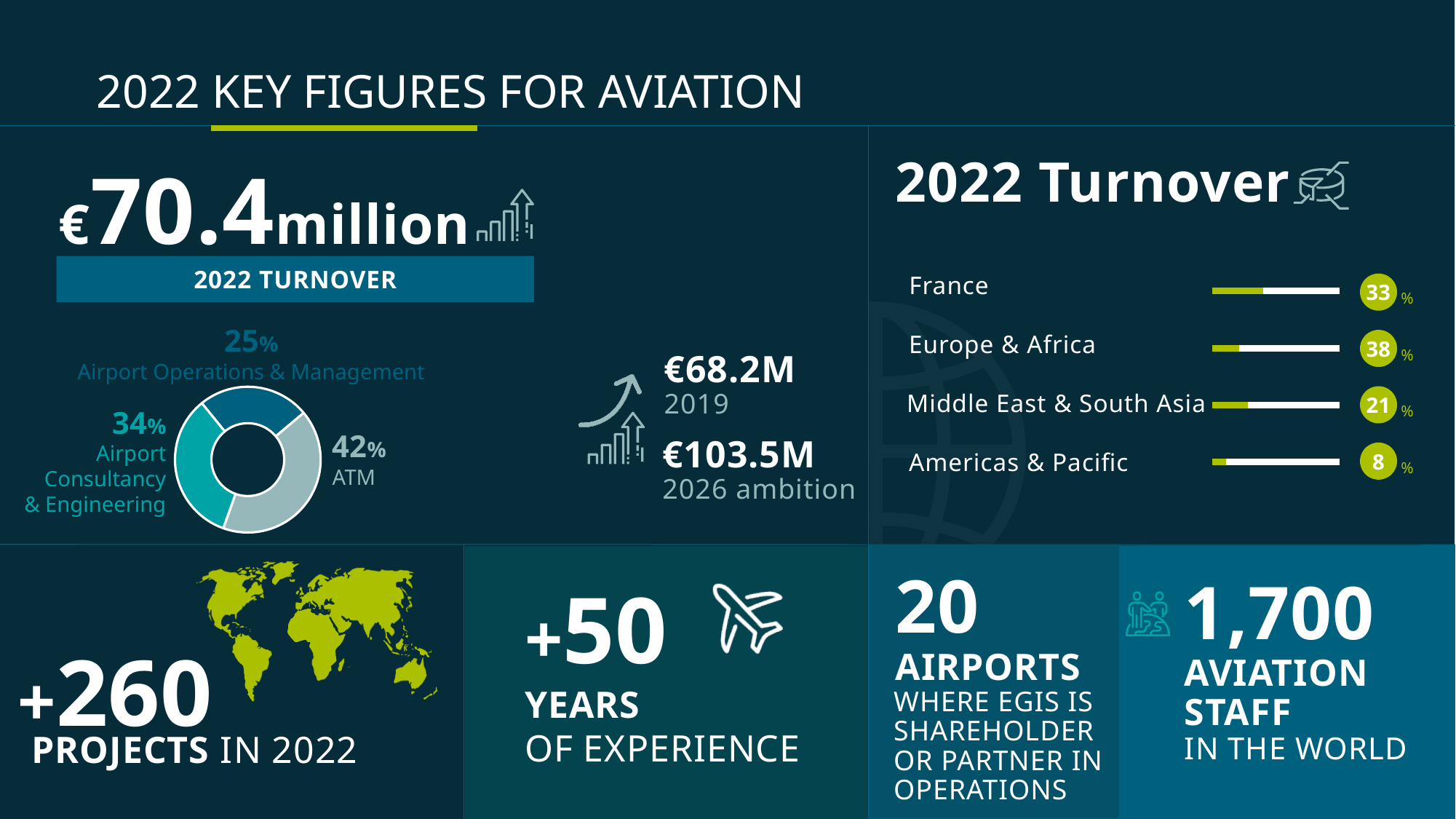
In the 2022 Turnover chart on the right, which region has the lowest value? Americas & Pacific In the 2022 Turnover chart on the right, which region has the highest value? Europe & Africa In the donut chart on the left, how many segments are there? 3 In the donut chart on the left, what share is ATM? 42% In the 2022 Turnover chart on the right, what is the value for Americas & Pacific? 8% In the donut chart on the left, which segment is the largest? ATM In the donut chart on the left, what share is Airport Operations & Management? 25% In the 2022 Turnover chart on the right, what is the value for France? 33% In the donut chart on the left, what is the difference between the ATM share and the Airport Consultancy & Engineering share? 8% In the donut chart on the left, what share is Airport Consultancy & Engineering? 34% In the 2022 Turnover chart on the right, what is the difference between Europe & Africa and Middle East & South Asia? 17% In the donut chart on the left, which segment is the smallest? Airport Operations & Management